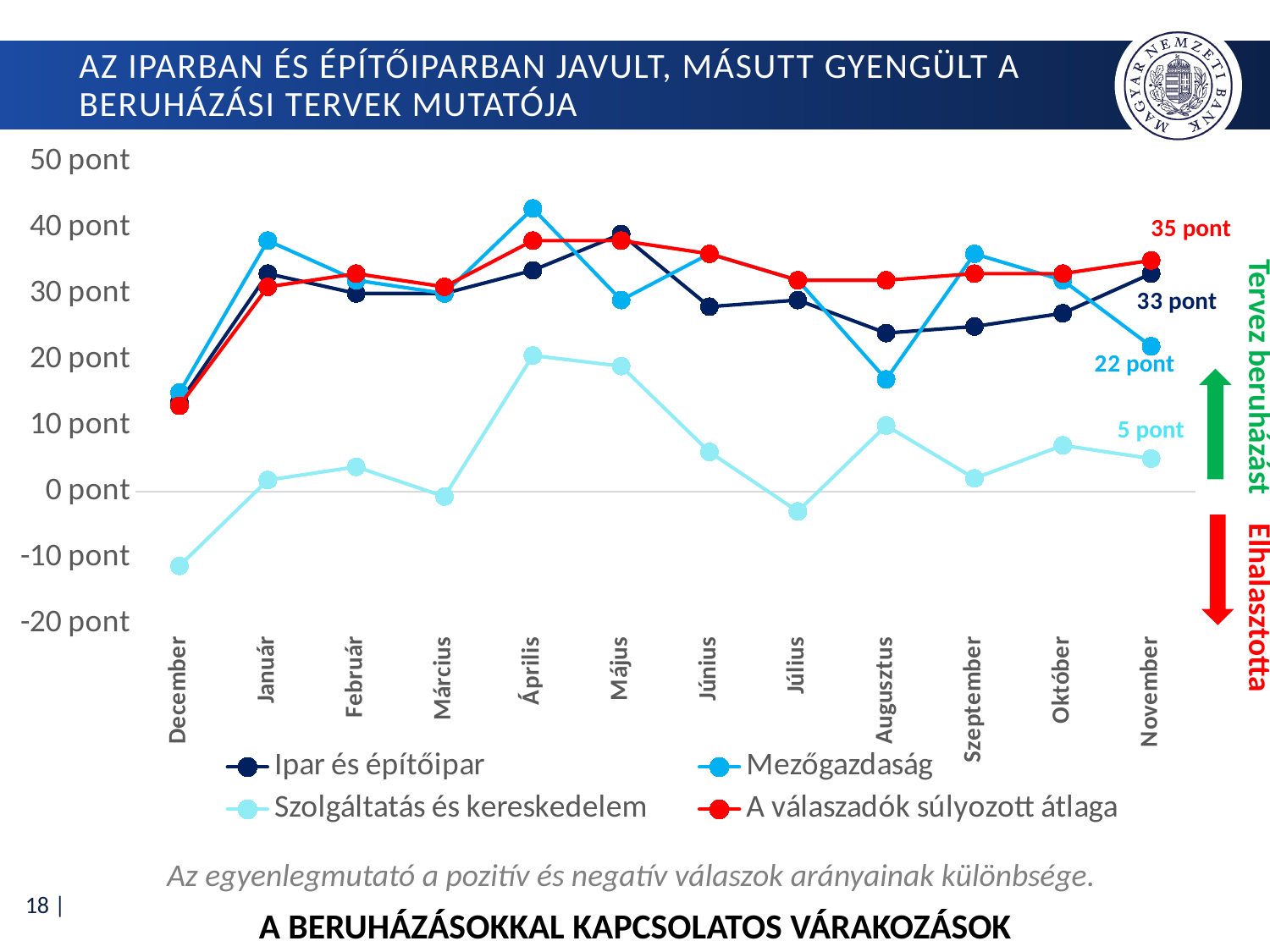
What is the November value for 'Mezőgazdaság'? 22 pont Is the value for 'Szolgáltatás és kereskedelem' in December greater or less than 0 pont? less What is the difference between the November values of 'A válaszadók súlyozott átlaga' and 'Mezőgazdaság'? 13 pont Which series has the lowest value in November? Szolgáltatás és kereskedelem What is the November value for 'A válaszadók súlyozott átlaga'? 35 pont Is the value for 'Mezőgazdaság' in Április greater or less than 40 pont? greater How many series does the legend list? 4 What type of chart is shown on the slide? line chart What is the November value for 'Szolgáltatás és kereskedelem'? 5 pont How many months are shown along the x axis? 12 Which series has the highest value in November? A válaszadók súlyozott átlaga What is the November value for 'Ipar és építőipar'? 33 pont